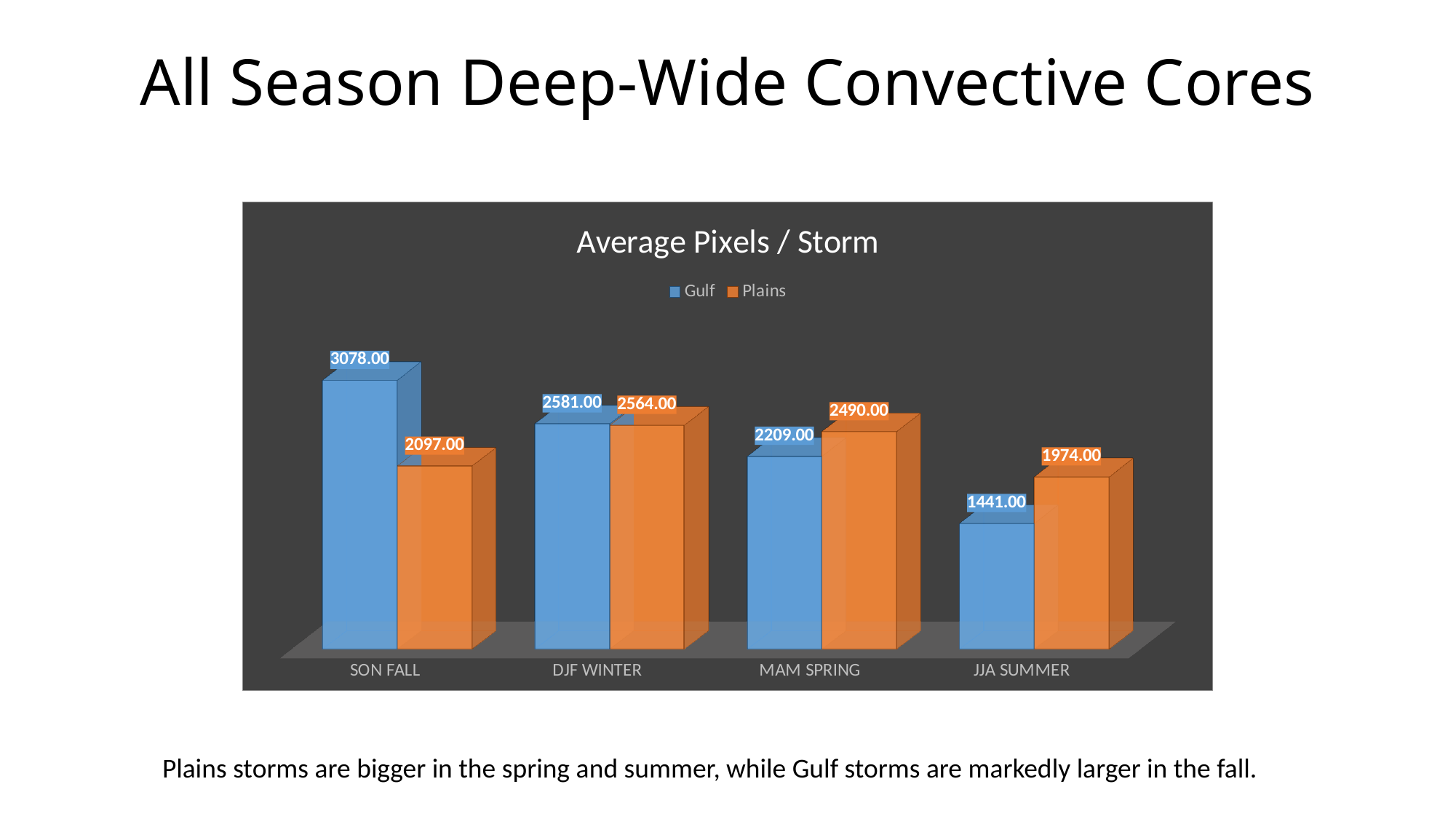
What is the Gulf value for SON FALL? 3078.00 What is the Gulf value for JJA SUMMER? 1441.00 For MAM SPRING, which series has the larger value, Gulf or Plains? Plains What is the Plains value for DJF WINTER? 2564.00 How many series does the legend list? 2 What is the Plains value for MAM SPRING? 2490.00 How many seasons are shown on the x axis? 4 What is the difference between the Plains and Gulf values for JJA SUMMER? 533.00 What is the difference between the Gulf and Plains values for SON FALL? 981.00 Which season has the lowest Plains value? JJA SUMMER Which season has the highest Gulf value? SON FALL What kind of chart is shown on the slide? Bar chart